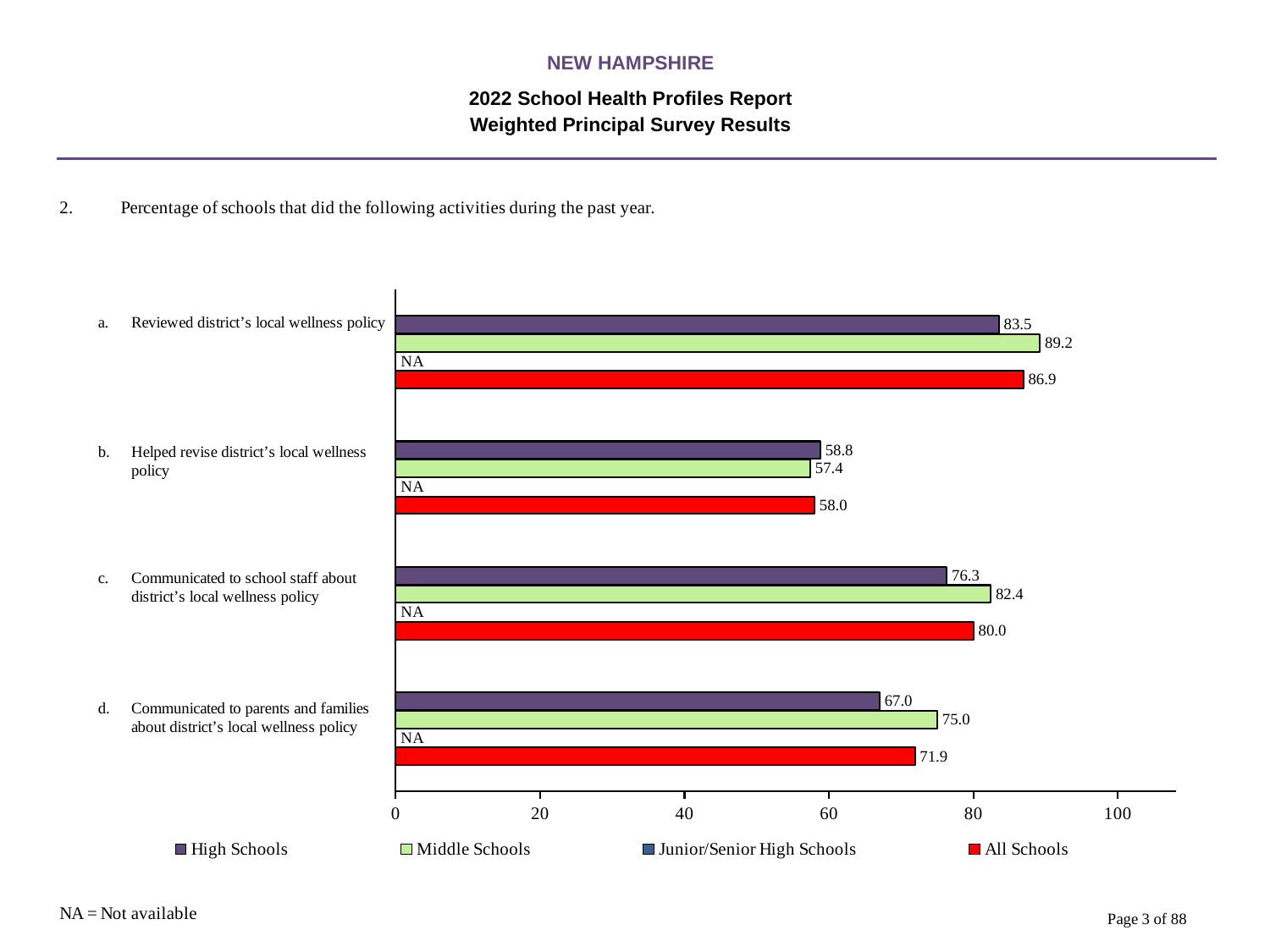
What is the All Schools value for 'Communicated to parents and families about district's local wellness policy'? 71.9 Which activity has the highest All Schools percentage? Reviewed district's local wellness policy How many activities (categories) are shown on the chart? 4 What value is shown for Junior/Senior High Schools for 'Communicated to school staff about district's local wellness policy'? NA What kind of chart is shown on the slide? Bar chart Is the All Schools value for 'Helped revise district's local wellness policy' greater or less than 60? less For 'Communicated to school staff about district's local wellness policy', which is larger: High Schools or Middle Schools? Middle Schools What is the difference between the Middle Schools and High Schools values for 'Communicated to parents and families about district's local wellness policy'? 8.0 Which activity has the lowest High Schools percentage? Helped revise district's local wellness policy What percentage of High Schools reviewed the district's local wellness policy? 83.5 What is the Middle Schools value for 'Helped revise district's local wellness policy'? 57.4 How many series does the legend list? 4